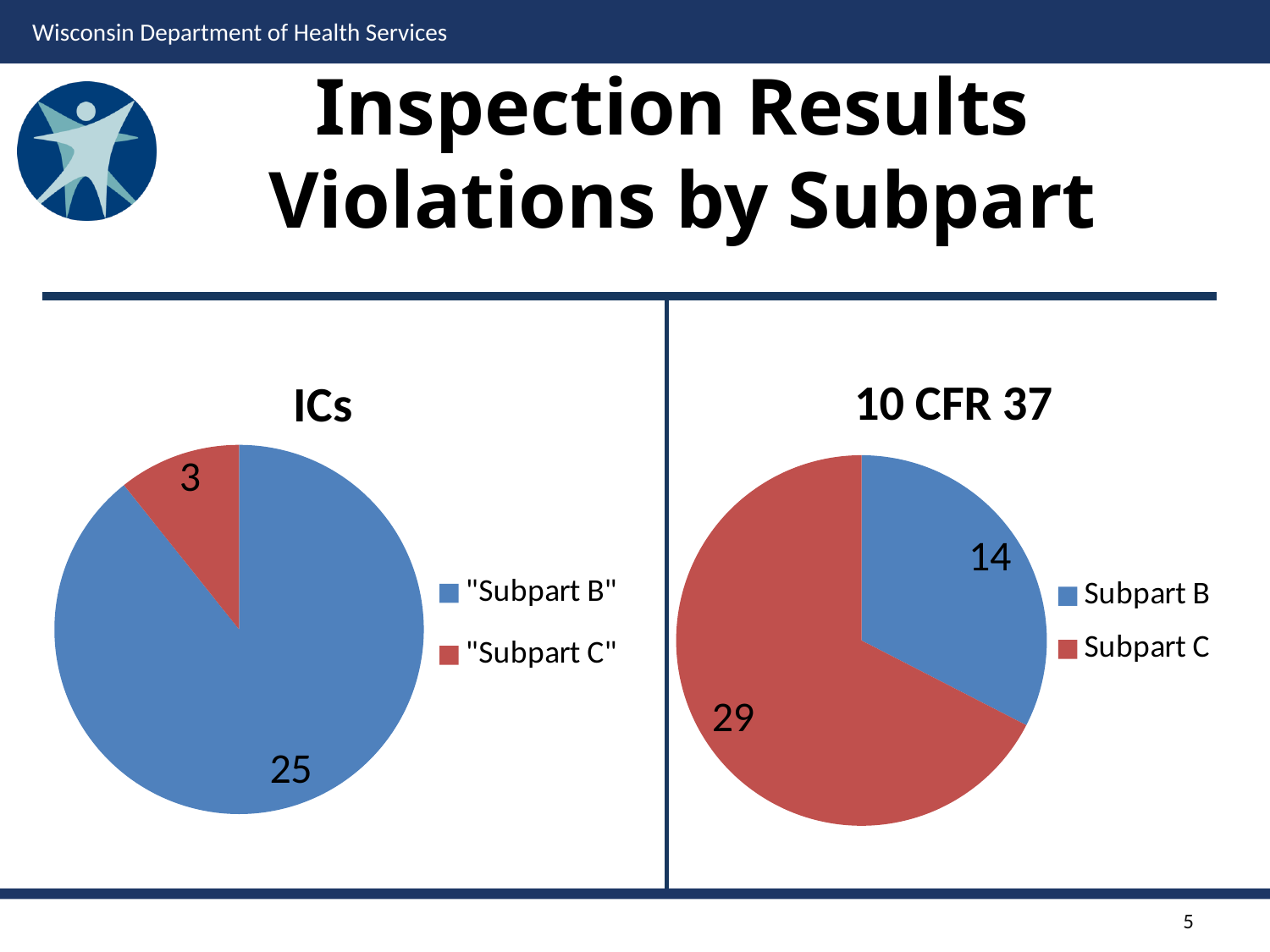
What type of chart is the 10 CFR 37 chart? Pie chart In the ICs chart, what is the value for "Subpart C"? 3 In the ICs chart, what is the value for "Subpart B"? 25 In the 10 CFR 37 chart, which subpart has the smaller slice? Subpart B In the 10 CFR 37 chart, what is the value for Subpart B? 14 How many slices does the ICs pie chart have? 2 What colour is the Subpart C slice in the 10 CFR 37 chart? Red In the 10 CFR 37 chart, what is the value for Subpart C? 29 Is the Subpart B value larger in the ICs chart or in the 10 CFR 37 chart? ICs In the 10 CFR 37 chart, how much larger is Subpart C than Subpart B? 15 In the ICs chart, what is the difference between the "Subpart B" and "Subpart C" values? 22 In the ICs chart, which subpart has the larger slice? "Subpart B"